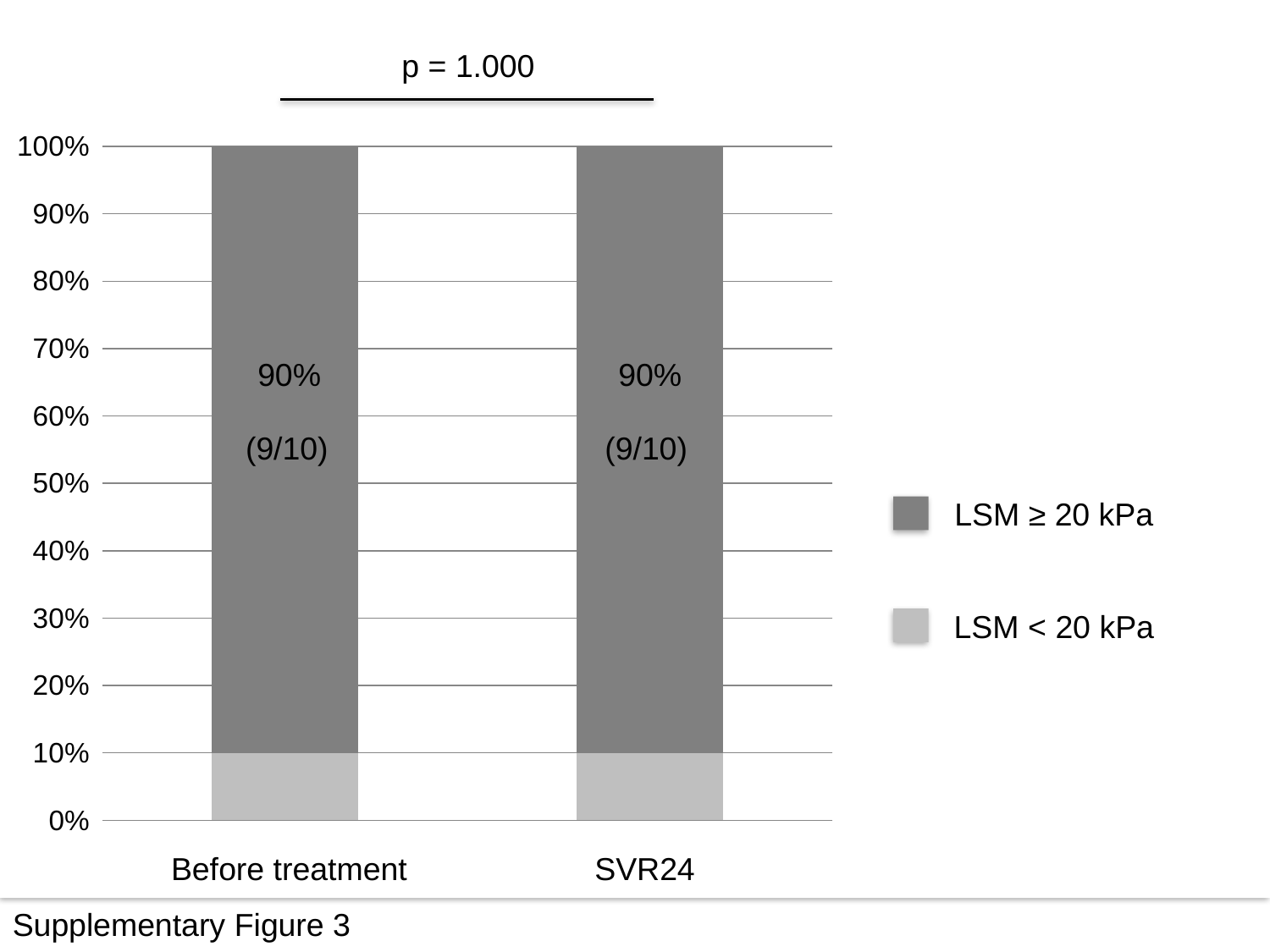
What percentage is shown for LSM ≥ 20 kPa in the Before treatment bar? 90% Is the LSM ≥ 20 kPa value for SVR24 greater or less than 50%? greater What fraction is printed inside the SVR24 bar for LSM ≥ 20 kPa? (9/10) What is the share of LSM < 20 kPa in the Before treatment bar, as read from the axis tick where the segment ends? 10% How many categories are shown on the x axis? 2 Which legend entry is shown in the darker grey colour? LSM ≥ 20 kPa How many series does the legend list? 2 What is the total height of the Before treatment stacked bar? 100% What percentage is shown for LSM ≥ 20 kPa in the SVR24 bar? 90% What kind of chart is shown on the slide? Stacked bar chart What is the difference between the LSM ≥ 20 kPa percentages for Before treatment and SVR24? 0% What p-value is printed above the bars? p = 1.000